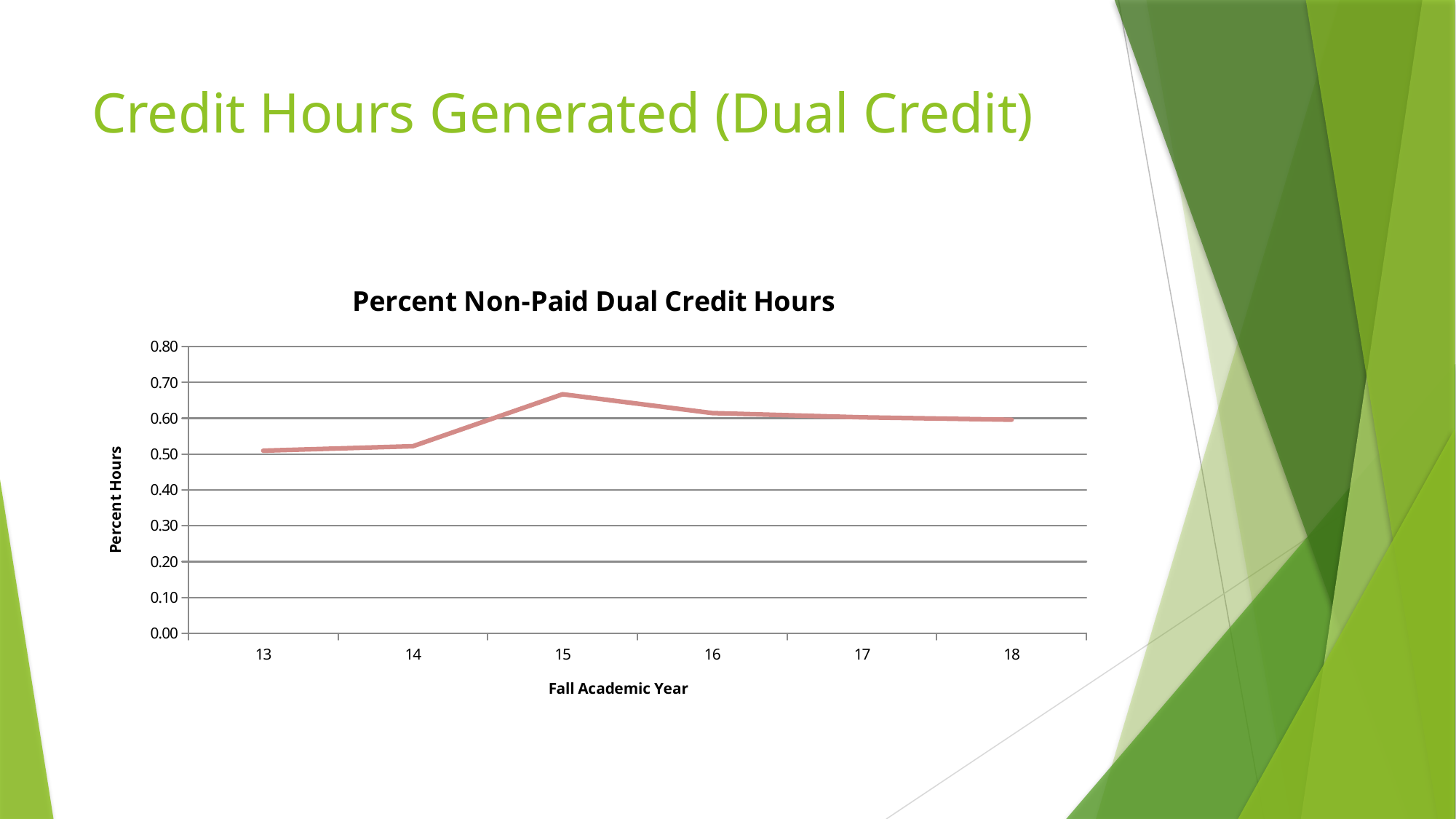
Is the value for fall academic year 13 greater or less than 0.60? less What is the label of the x axis? Fall Academic Year Which is larger, the value for fall academic year 14 or for fall academic year 16? 16 Which fall academic year has the highest percent of non-paid dual credit hours? 15 Which is larger, the value for fall academic year 15 or for fall academic year 13? 15 What kind of chart is shown on the slide? line chart Is the value for fall academic year 15 greater or less than 0.70? less Is the value for fall academic year 15 greater or less than 0.60? greater What is the title of the chart? Percent Non-Paid Dual Credit Hours Do the values rise or fall from fall academic year 15 to fall academic year 18? fall How many fall academic years are plotted on the chart? 6